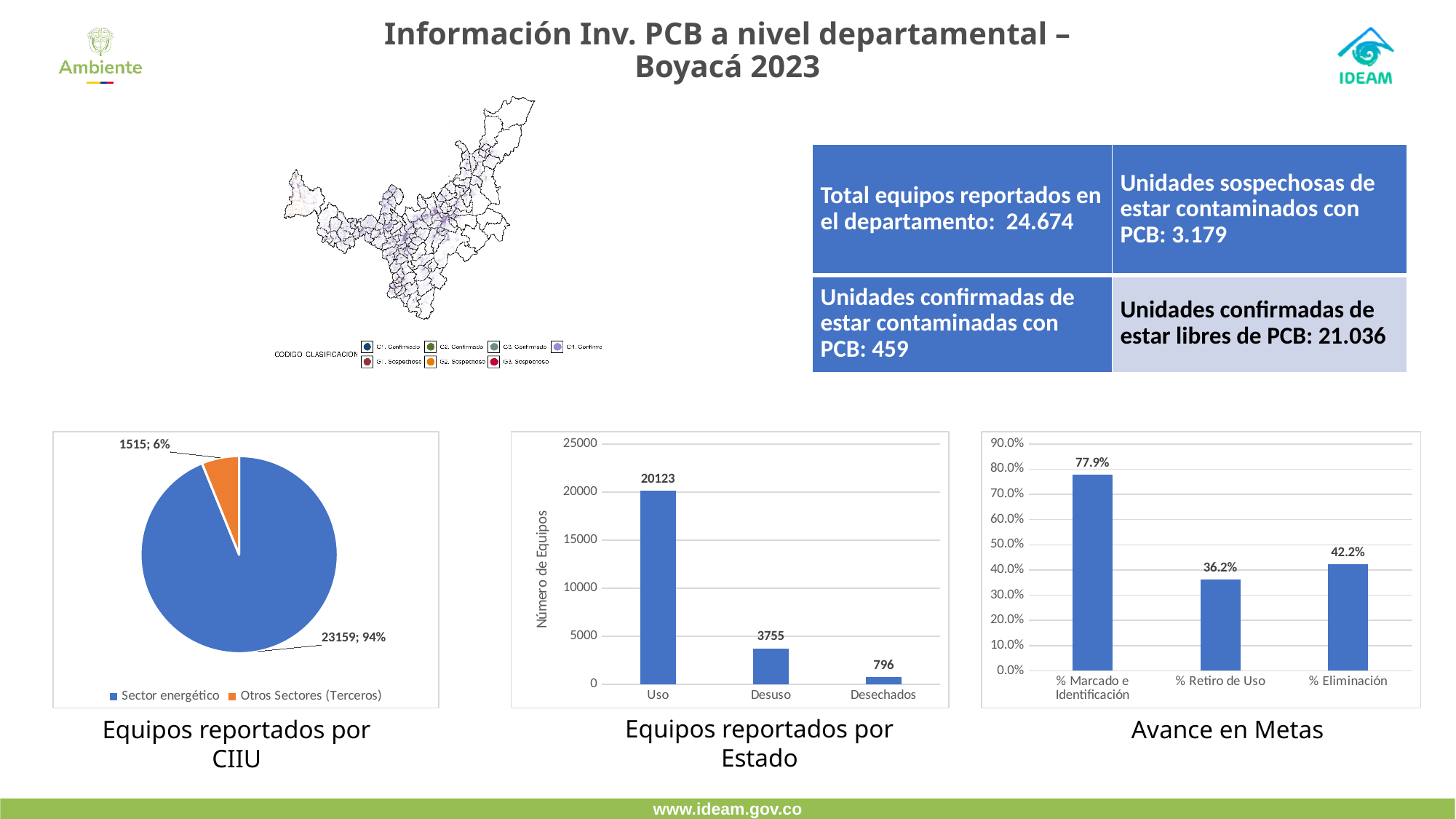
How many series does the legend of the 'Equipos reportados por CIIU' chart list? 2 In the 'Equipos reportados por CIIU' pie chart, what share of the pie does Otros Sectores (Terceros) have? 6% In the 'Equipos reportados por Estado' chart, what is the value for Desuso? 3755 In the 'Avance en Metas' chart, what is the value for % Retiro de Uso? 36.2% What is the y-axis title of the 'Equipos reportados por Estado' chart? Número de Equipos In the 'Equipos reportados por Estado' chart, which category has the lowest value? Desechados How many categories are shown in the 'Avance en Metas' chart? 3 In the 'Equipos reportados por Estado' chart, what is the difference between Uso and Desuso? 16368 In the 'Avance en Metas' chart, which is larger: % Eliminación or % Retiro de Uso? % Eliminación What kind of chart is 'Equipos reportados por CIIU'? Pie chart In the 'Equipos reportados por CIIU' pie chart, what value is shown for Sector energético? 23159; 94% In the 'Equipos reportados por Estado' chart, which category has the highest value? Uso